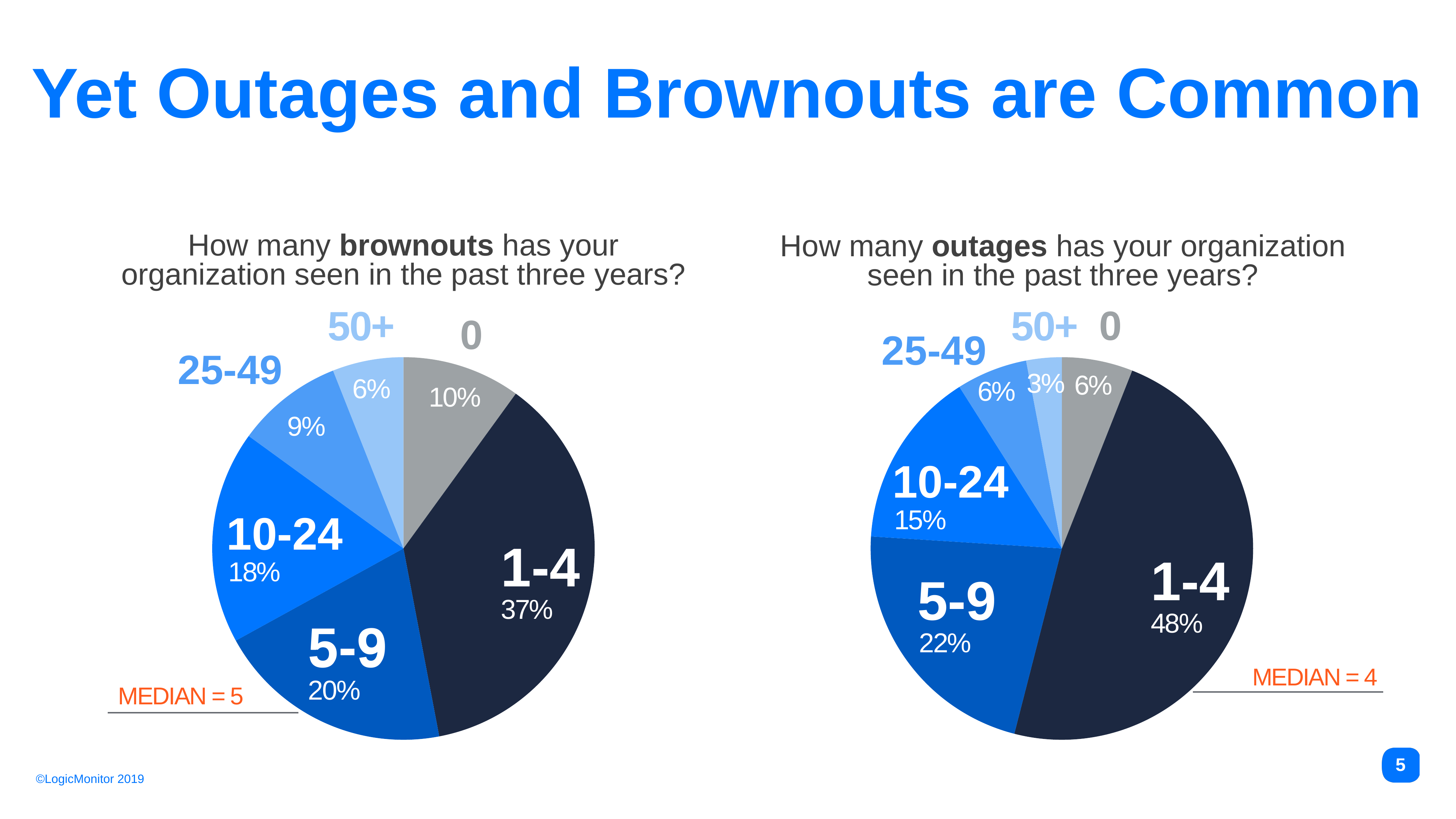
What median value is shown for the outages chart? MEDIAN = 4 In the outages pie chart, what percentage of organizations reported 1-4 outages? 48% In the brownouts pie chart, which category has the largest share? 1-4 How many categories does the brownouts pie chart show? 6 In the outages pie chart, what is the difference between the 1-4 share and the 5-9 share? 26% In the outages pie chart, which category has the smallest share? 50+ What type of chart is used on this slide? Pie chart In the brownouts pie chart, what percentage of organizations reported 1-4 brownouts? 37% In the outages pie chart, what percentage reported 50+ outages? 3% In the brownouts pie chart, what percentage reported 0 brownouts? 10% Which is larger: the 10-24 share in the brownouts chart or the 10-24 share in the outages chart? Brownouts (18%) In the brownouts pie chart, what is the difference between the 5-9 share and the 25-49 share? 11%